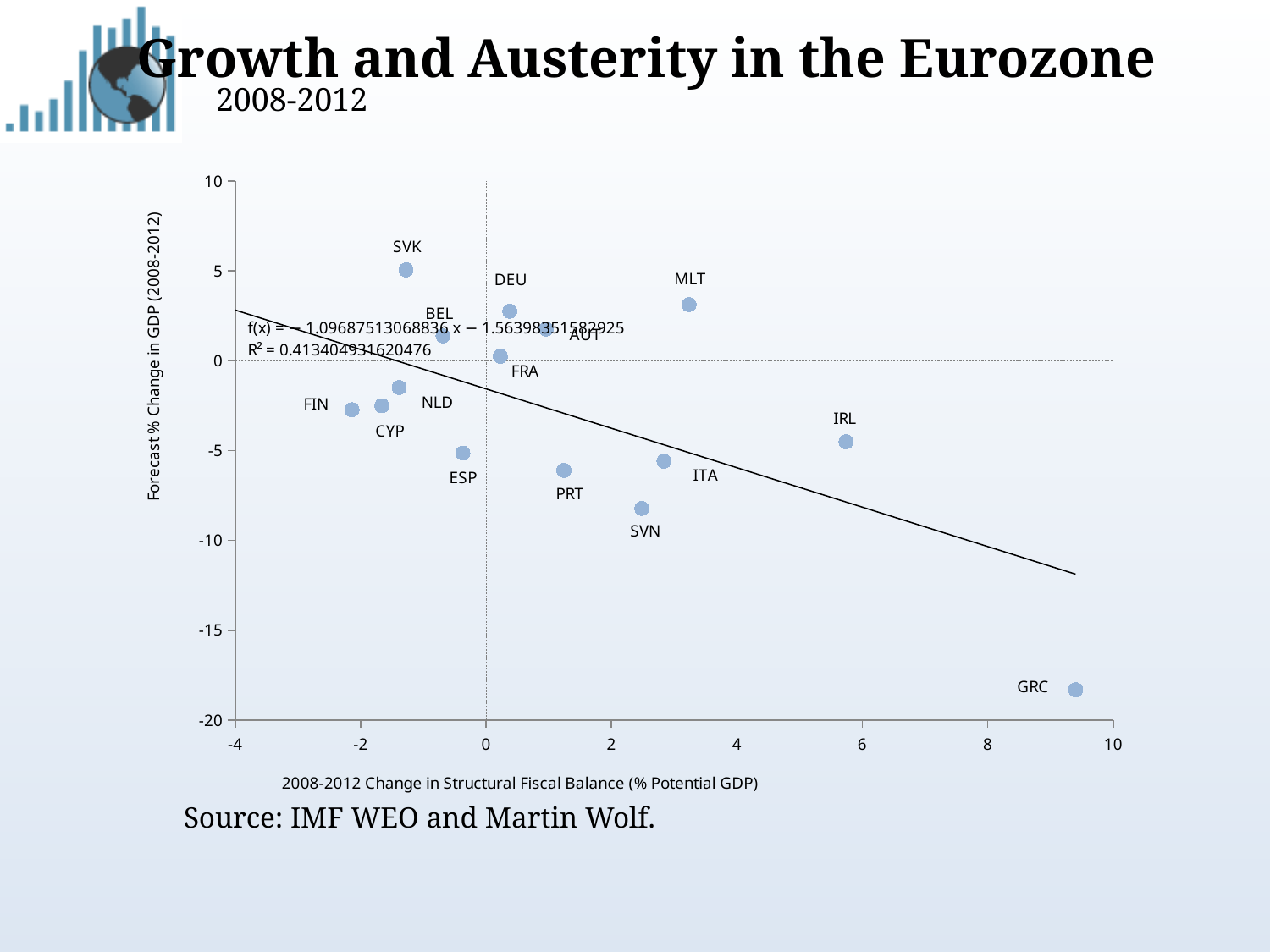
Is the change in structural fiscal balance for IRL greater or less than 4? greater What R² value is shown for the trend line? 0.413404931620476 Which country has the lowest forecast % change in GDP? GRC Which country has the highest forecast % change in GDP? SVK What kind of chart is shown on the slide? Scatter chart As the change in structural fiscal balance increases, does the fitted trend line rise or fall? Fall Is the forecast % change in GDP for GRC greater or less than -15? less Is the forecast % change in GDP for PRT greater or less than -5? less Which country has the largest 2008-2012 change in structural fiscal balance? GRC Which has a higher forecast % change in GDP, SVK or MLT? SVK